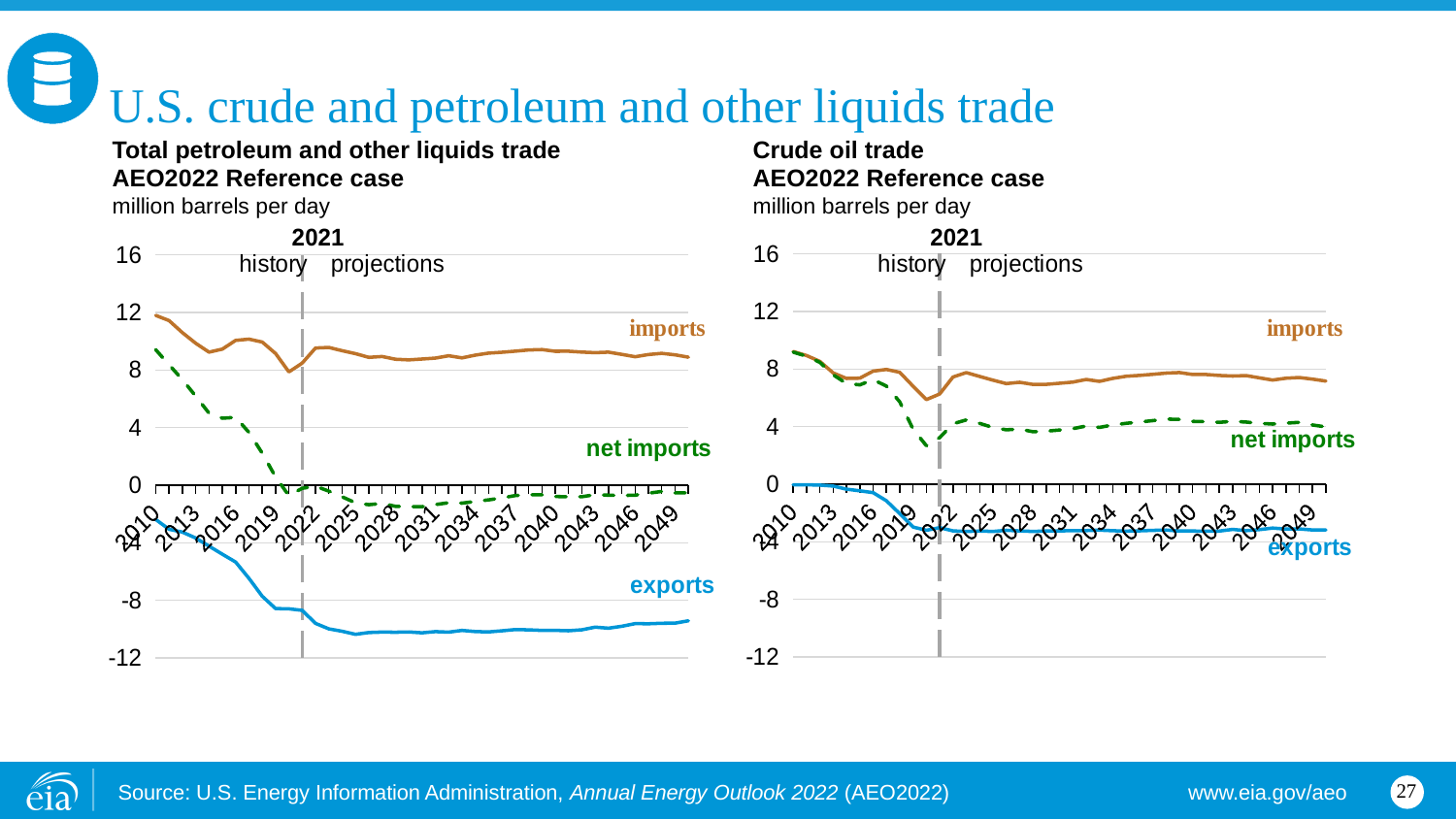
On the 'Total petroleum and other liquids trade' chart, is the value for exports in 2049 greater or less than -8? less On the 'Total petroleum and other liquids trade' chart, is the value for imports in 2049 greater or less than 8? greater On the 'Crude oil trade' chart, is the value for net imports in 2010 greater or less than 8? greater On the 'Crude oil trade' chart, in 2049, which is larger: imports or net imports? imports Which year does the vertical dashed line separating history from projections mark on both charts? 2021 How many series are labelled on the 'Crude oil trade' chart on the right? 3 What kind of chart is the 'Total petroleum and other liquids trade' chart on the left? line chart On the 'Total petroleum and other liquids trade' chart, do exports rise or fall between 2010 and 2022? fall What unit is used on the y axis of both charts? million barrels per day